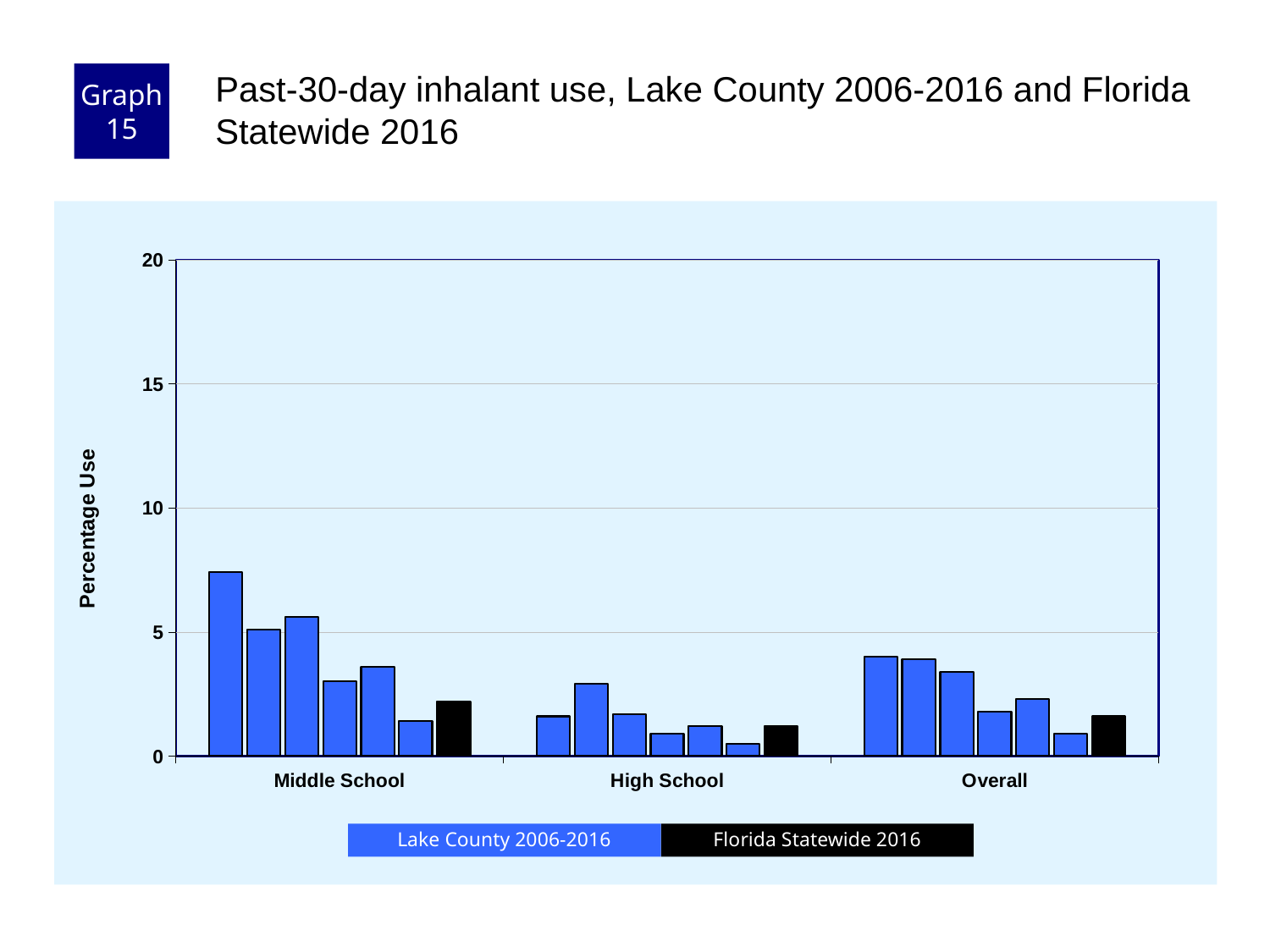
Which is larger: the Florida Statewide 2016 value for Middle School or for High School? Middle School What kind of chart is shown on the slide? bar chart Which category contains the tallest bar in the chart? Middle School Which category has the tallest Florida Statewide 2016 bar? Middle School Is the tallest Middle School bar greater or less than 10? less Which series is shown in black? Florida Statewide 2016 How many categories are shown on the x axis? 3 Is the Florida Statewide 2016 value for High School greater or less than 5? less Is the tallest Overall bar greater or less than 5? less What is the label on the y axis? Percentage Use How many series does the legend list? 2